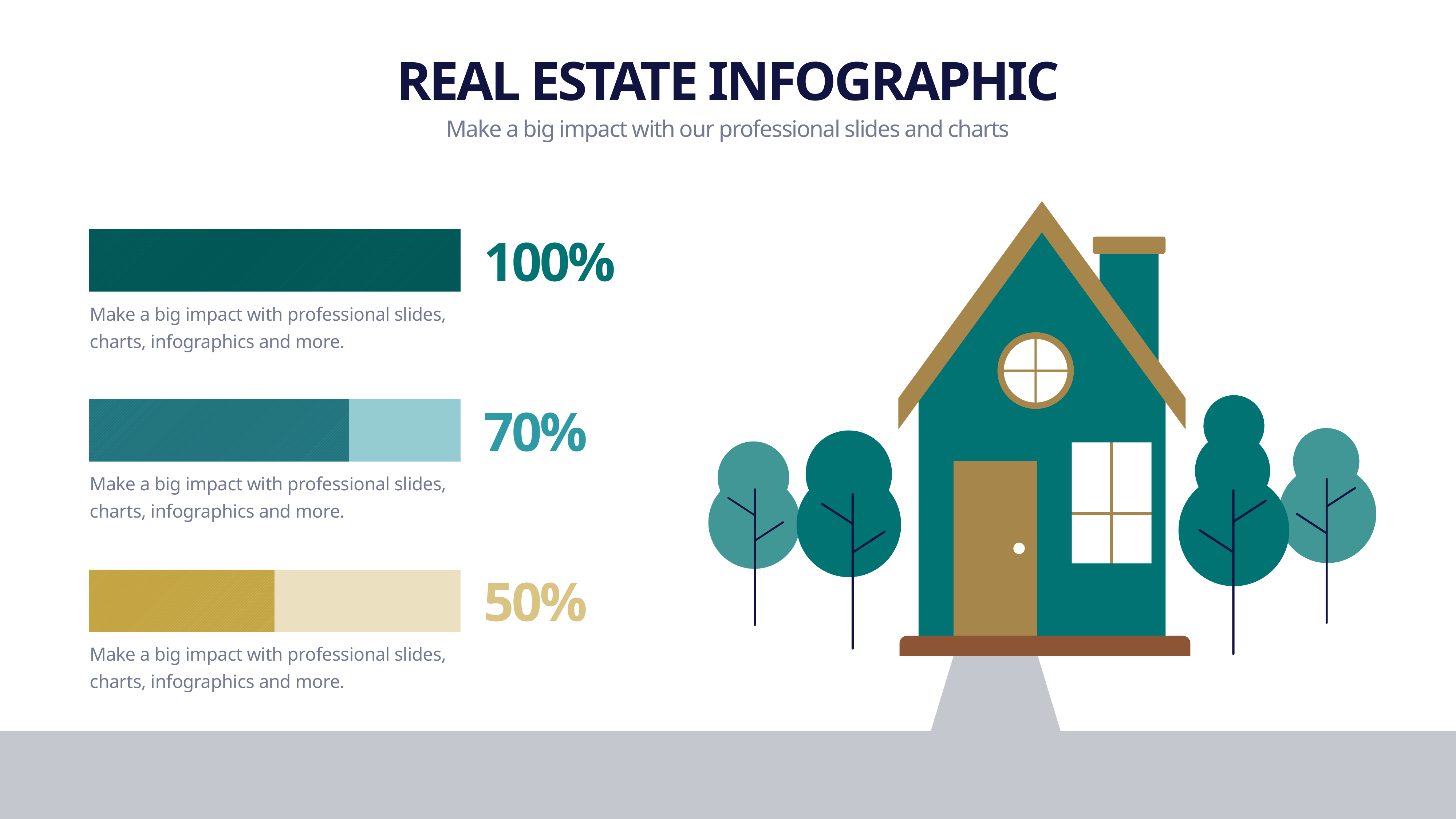
Do the bar values increase or decrease from top to bottom? Decrease What value is shown for the middle bar? 70% Which is larger, the value of the middle bar or the value of the bottom bar? The middle bar (70%) What is the difference between the top bar's value and the middle bar's value? 30% What value is shown for the top bar? 100% How many bars are shown on the slide? 3 Which bar has the lowest value? The bottom bar (50%) What value is shown for the bottom (gold) bar? 50% What is the difference between the middle bar's value and the bottom bar's value? 20% What is the title of the slide? REAL ESTATE INFOGRAPHIC Which bar has the highest value? The top bar (100%) What kind of chart is shown on the slide? Bar chart